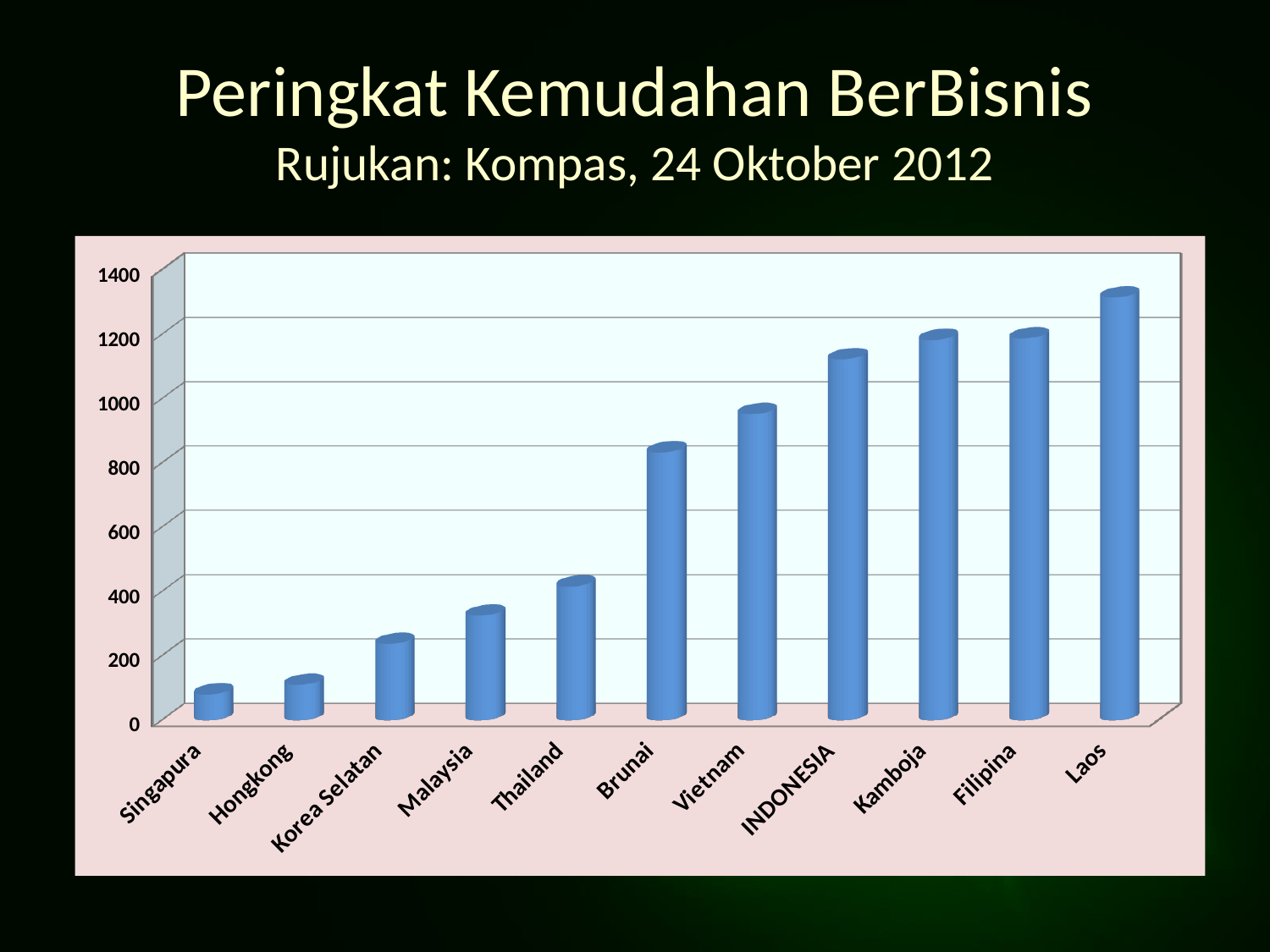
Is the value for Laos greater or less than 1200? greater Is the value for Brunai greater or less than 1000? less Which country has the highest bar in the chart? Laos Do the values generally rise or fall moving from Singapura on the left to Laos on the right? rise Which has the larger value, INDONESIA or Vietnam? INDONESIA Is the value for Singapura greater or less than 200? less How many countries are shown on the x axis of the chart? 11 What kind of chart is shown on the slide? bar chart What is the title of the slide containing the chart? Peringkat Kemudahan BerBisnis